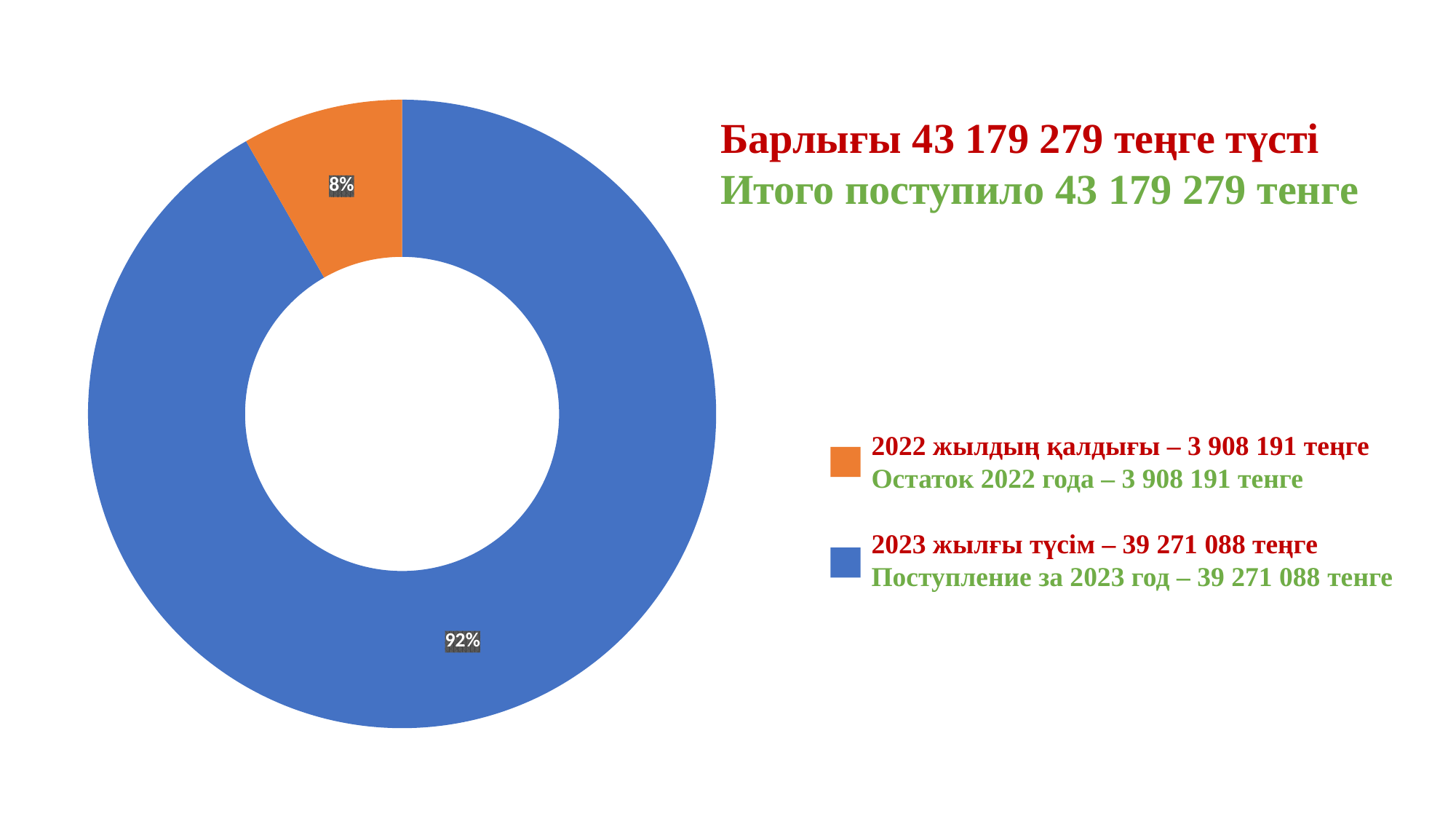
What percentage share is shown for the orange slice (Остаток 2022 года)? 8% Which slice is the smallest in the doughnut chart? Остаток 2022 года (8%) According to the legend, what amount in tenge corresponds to Поступление за 2023 год? 39 271 088 тенге What kind of chart is shown on the slide? Doughnut chart Which slice is the largest in the doughnut chart? Поступление за 2023 год (92%) What colour is the slice representing Поступление за 2023 год? Blue What percentage share is shown for the blue slice (Поступление за 2023 год)? 92% What total amount received is stated on the slide? 43 179 279 тенге According to the legend, what amount in tenge corresponds to Остаток 2022 года? 3 908 191 тенге How many slices does the doughnut chart have? 2 Which is larger: the share for Остаток 2022 года or the share for Поступление за 2023 год? Поступление за 2023 год What is the difference in percentage points between the 2023 receipts slice and the 2022 remainder slice? 84 percentage points